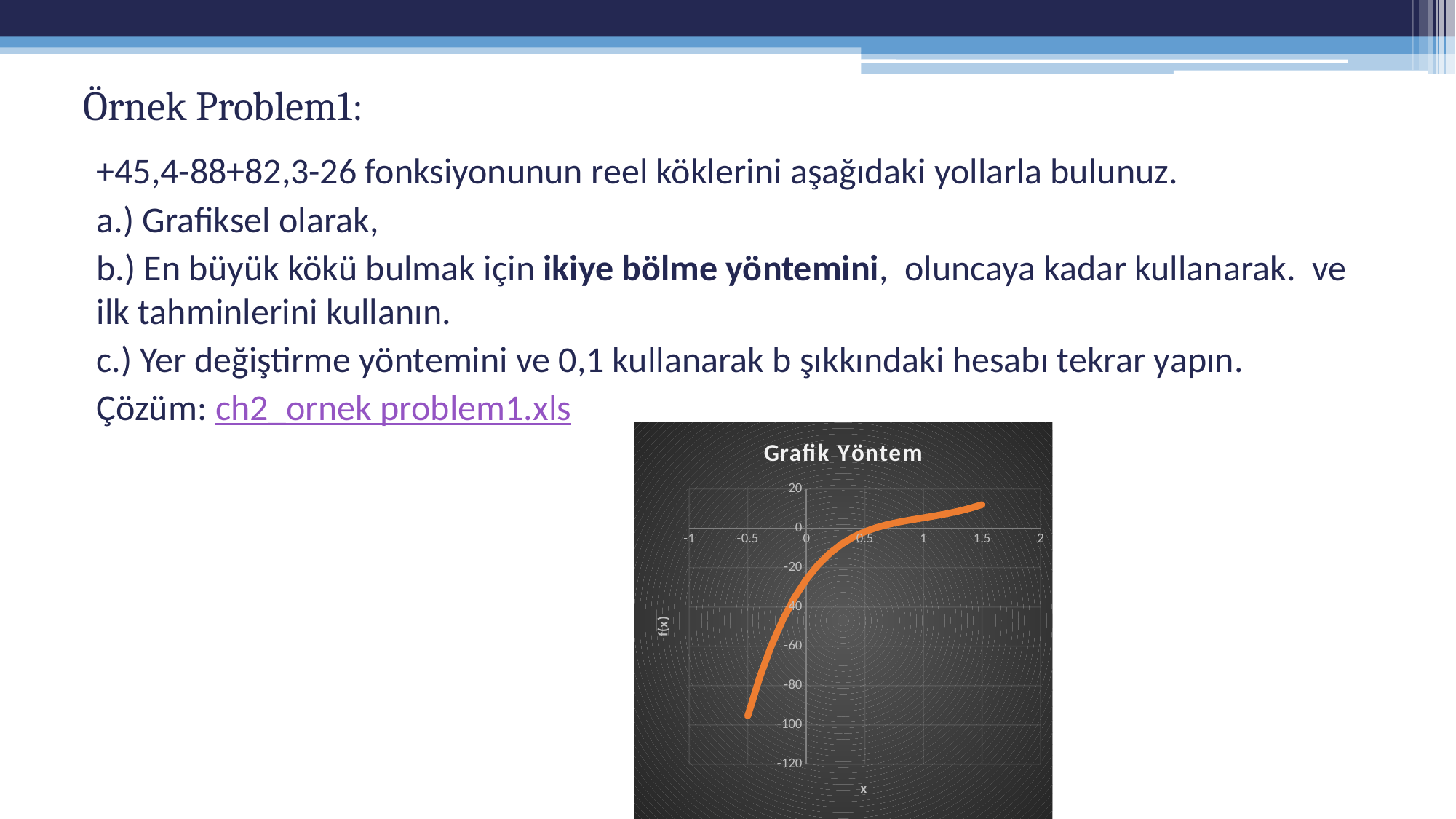
Is the value of f(x) at x = -0.5 greater or less than -80? less At which x value does the plotted curve reach its highest f(x)? 1.5 What label is shown on the vertical axis of the chart? f(x) Is the value of f(x) at x = 1.5 greater or less than 20? less Which is larger, f(x) at x = 1.5 or f(x) at x = -0.5? f(x) at x = 1.5 Do the plotted values rise or fall as x increases along the x axis? rise What is the title of the chart on the slide? Grafik Yöntem At which x value does the plotted curve reach its lowest f(x)? -0.5 What kind of chart is shown under the title "Grafik Yöntem"? line chart Is the value of f(x) at x = 1.5 greater or less than 0? greater